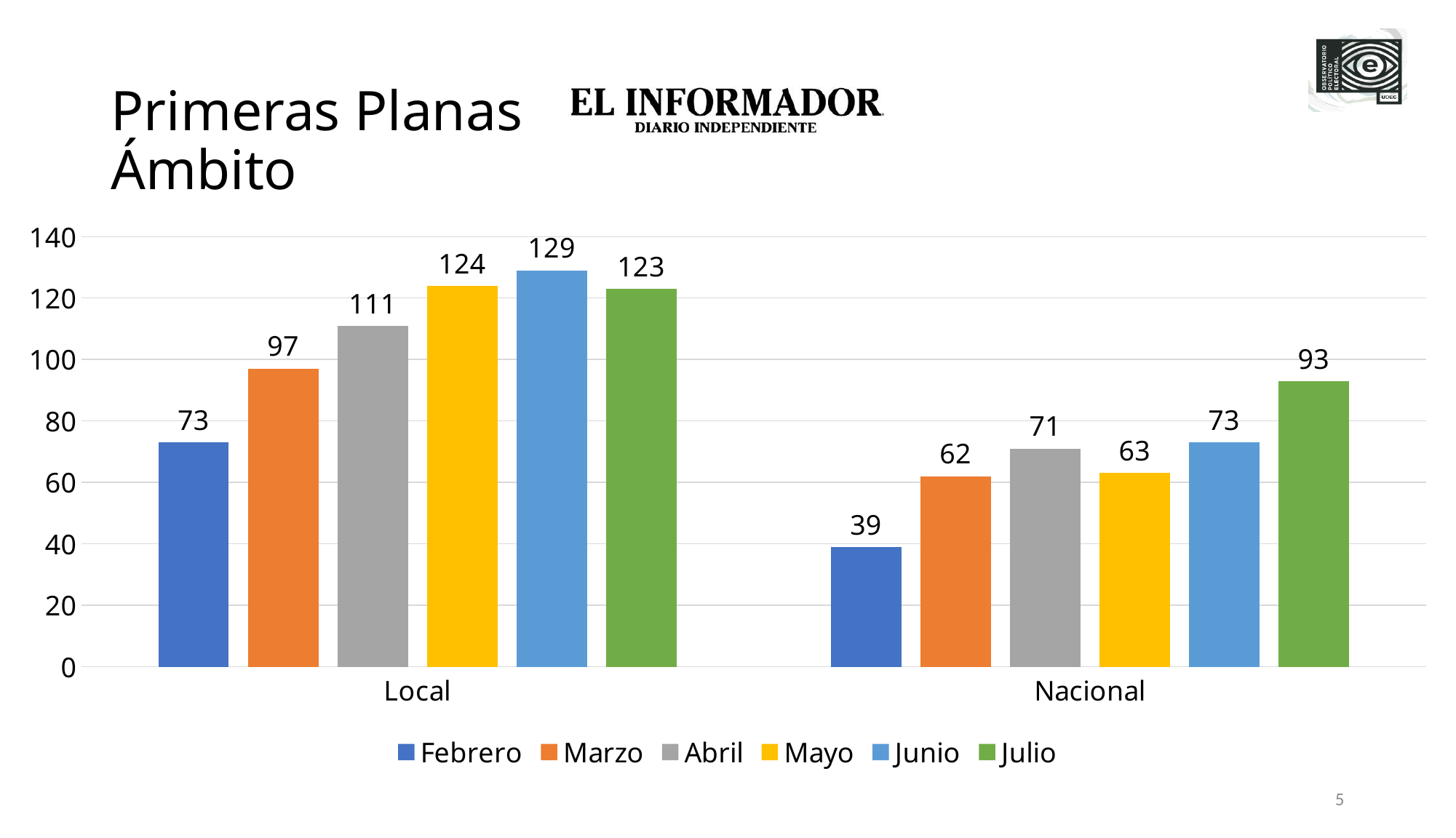
What is the difference between the Junio and Febrero values in the Nacional category? 34 Which is larger: Marzo in Local or Julio in Nacional? Marzo in Local What is the value for Abril in the Local category? 111 Which month has the highest value in the Nacional category? Julio What is the value for Febrero in the Nacional category? 39 How many series does the legend list? 6 What is the difference between the Mayo values for Local and Nacional? 61 How many categories are shown on the x axis? 2 What is the value for Junio in the Local category? 129 Which month has the lowest value in the Local category? Febrero What kind of chart is shown on the slide? Bar chart Which colour represents Mayo in the legend? Yellow